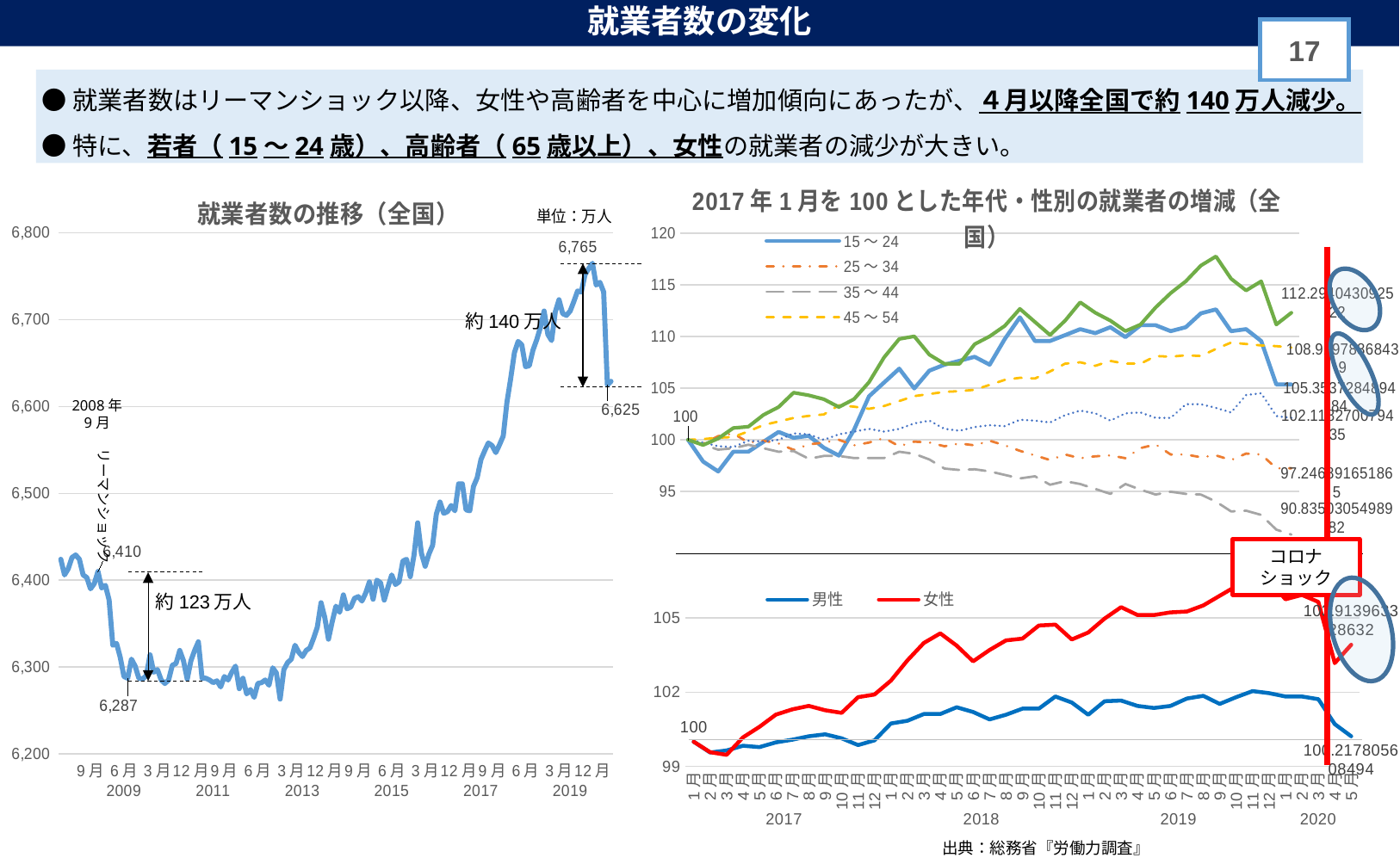
In the left chart 就業者数の推移（全国）, what is the value labelled at 2008年9月? 6,410 What kind of chart is the left chart titled 就業者数の推移（全国）? line chart In the left chart 就業者数の推移（全国）, what unit is shown for the values? 万人 In the upper-right chart (2017年1月を100とした年代・性別の就業者の増減), is the final value for 35～44 greater or less than 95? less In the left chart 就業者数の推移（全国）, what is the difference between the peak value 6,765 and the final value 6,625? 140 How many series does the legend of the upper-right chart (2017年1月を100とした年代・性別の就業者の増減) list? 4 In the left chart 就業者数の推移（全国）, what is the value labelled at the end of the series? 6,625 In the left chart 就業者数の推移（全国）, what is the peak value labelled near 2019? 6,765 In the lower-right chart with 男性 and 女性, is the final value for 男性 greater or less than 102? less In the upper-right chart (2017年1月を100とした年代・性別の就業者の増減), is the final value for 45～54 greater or less than 105? greater In the lower-right chart with 男性 and 女性, which series is higher at the end of the period? 女性 In the left chart 就業者数の推移（全国）, what is the lowest labelled value? 6,287